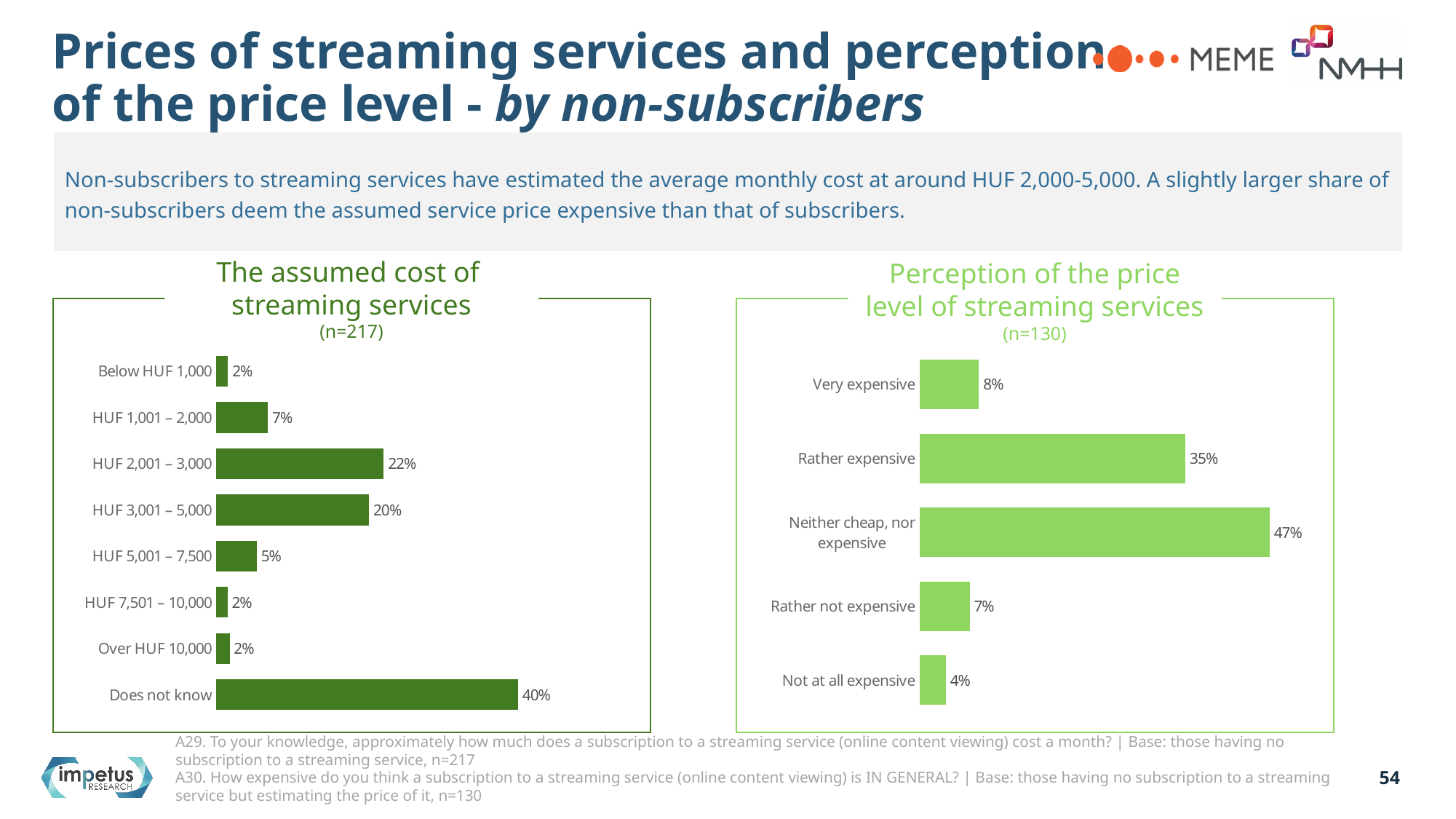
In the chart 'The assumed cost of streaming services', what is the value for HUF 5,001 – 7,500? 5% In the chart 'The assumed cost of streaming services', how many categories are shown? 8 In the chart 'The assumed cost of streaming services', what is the value for HUF 2,001 – 3,000? 22% In the chart 'Perception of the price level of streaming services', what is the difference between Neither cheap, nor expensive and Rather expensive? 12% In the chart 'Perception of the price level of streaming services', how many categories are shown? 5 In the chart 'Perception of the price level of streaming services', which is larger: Very expensive or Rather not expensive? Very expensive In the chart 'Perception of the price level of streaming services', which category has the lowest value? Not at all expensive What kind of chart is 'The assumed cost of streaming services'? Bar chart What is the sample size (n) shown under the title of the chart 'Perception of the price level of streaming services'? n=130 In the chart 'Perception of the price level of streaming services', what is the value for Rather expensive? 35% In the chart 'The assumed cost of streaming services', which category has the highest value? Does not know In the chart 'The assumed cost of streaming services', what is the difference between HUF 2,001 – 3,000 and HUF 3,001 – 5,000? 2%